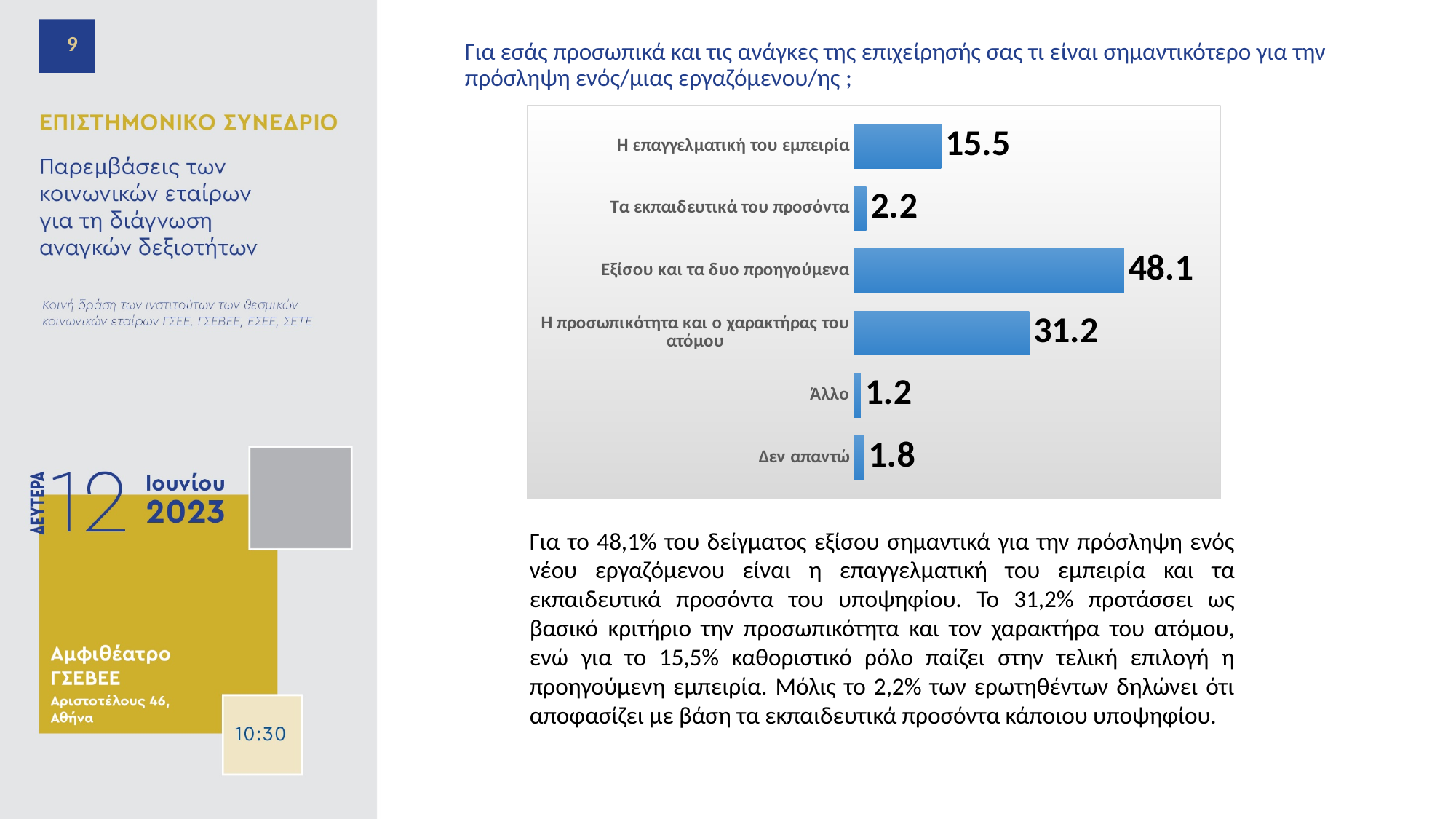
What is the value for "Δεν απαντώ"? 1.8 What is the difference between the values for "Η επαγγελματική του εμπειρία" and "Τα εκπαιδευτικά του προσόντα"? 13.3 Which category has the highest value? Εξίσου και τα δυο προηγούμενα What is the value for "Η επαγγελματική του εμπειρία"? 15.5 How many categories are shown in the chart? 6 What colour are the bars in the chart? Blue Which is larger, the value for "Δεν απαντώ" or the value for "Άλλο"? Δεν απαντώ What is the difference between the values for "Εξίσου και τα δυο προηγούμενα" and "Η προσωπικότητα και ο χαρακτήρας του ατόμου"? 16.9 Which category has the lowest value? Άλλο What is the value for "Τα εκπαιδευτικά του προσόντα"? 2.2 What is the value for "Η προσωπικότητα και ο χαρακτήρας του ατόμου"? 31.2 What kind of chart is shown on the slide? Bar chart